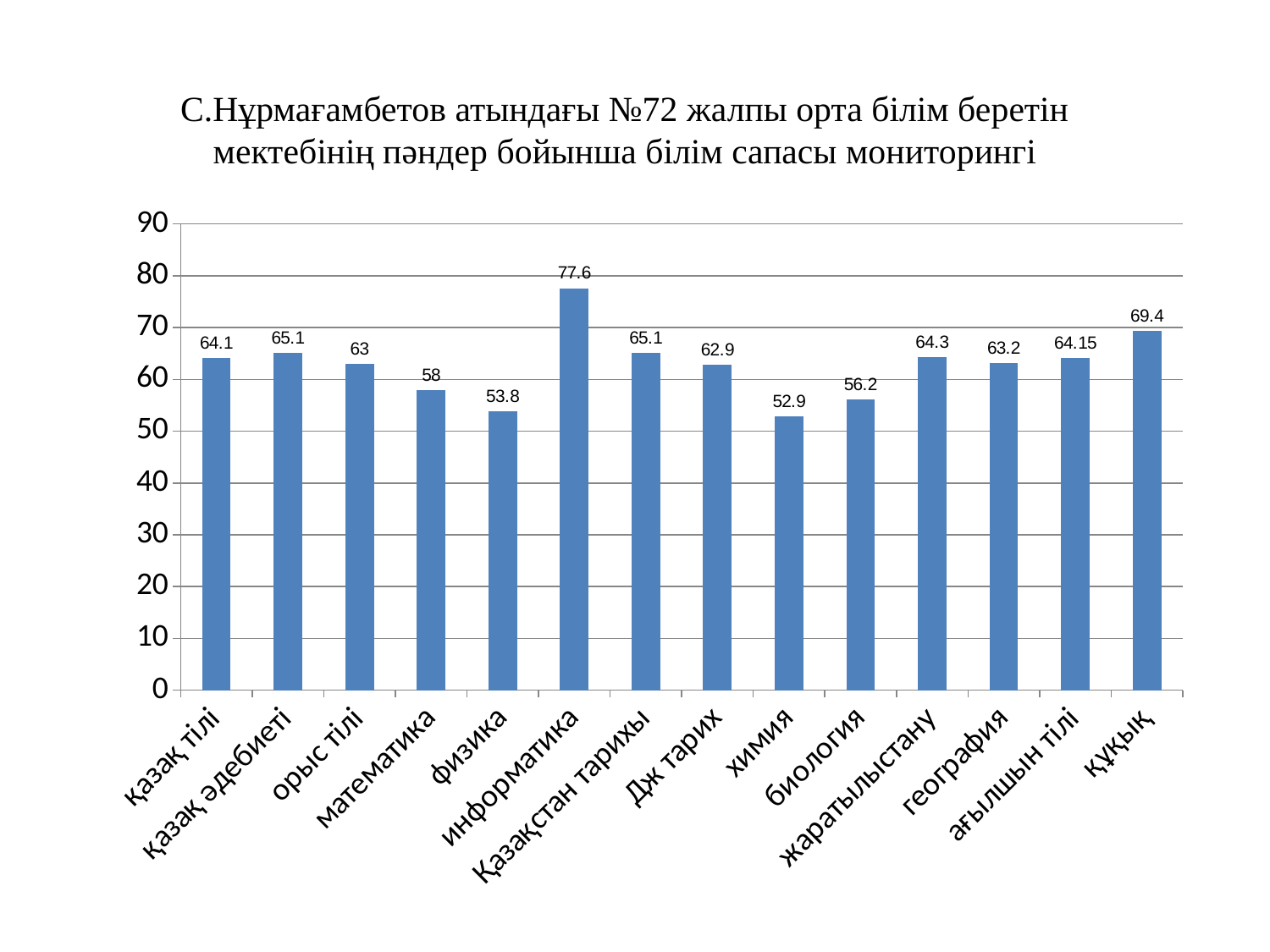
Which subject has the highest value? информатика Is the value for физика greater or less than 60? less Which subject has the lowest value? химия How many subjects are shown on the chart? 14 What kind of chart is shown on the slide? bar chart What is the difference between the values for құқық and физика? 15.6 Which is larger, the value for құқық or the value for география? құқық What is the value for биология? 56.2 What is the value for математика? 58 What is the difference between the values for информатика and химия? 24.7 What is the value for информатика? 77.6 What is the value for ағылшын тілі? 64.15